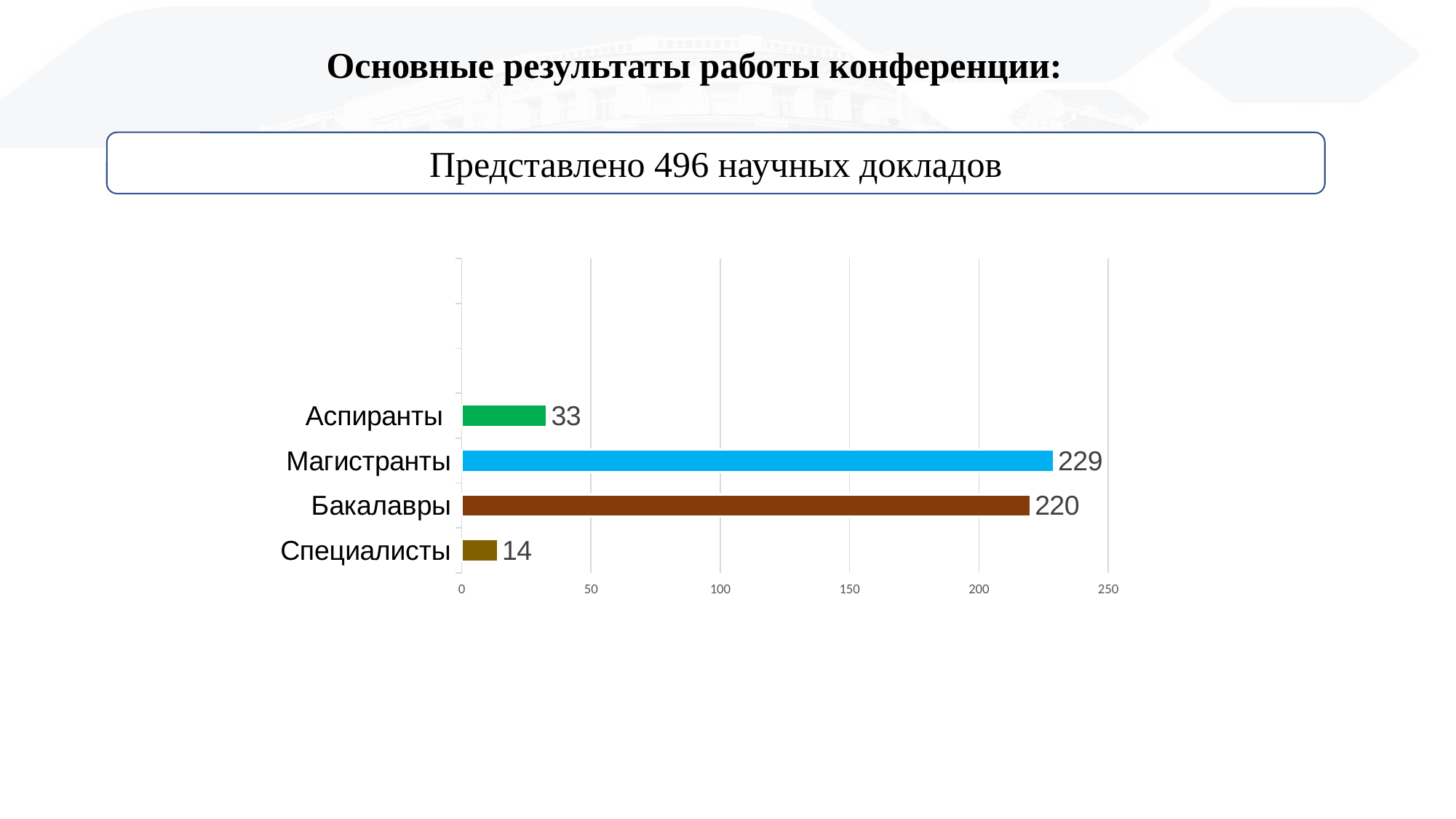
What is the value for Магистранты? 229 What is the value for Аспиранты? 33 What is the difference between the values for Магистранты and Бакалавры? 9 What kind of chart is shown on the slide? bar chart What is the difference between the values for Аспиранты and Специалисты? 19 Is the value for Бакалавры greater or less than 200? greater What is the value for Бакалавры? 220 Which is larger, the value for Аспиранты or the value for Специалисты? Аспиранты Which category has the highest value? Магистранты Which category has the lowest value? Специалисты What is the value for Специалисты? 14 How many categories are shown in the chart? 4